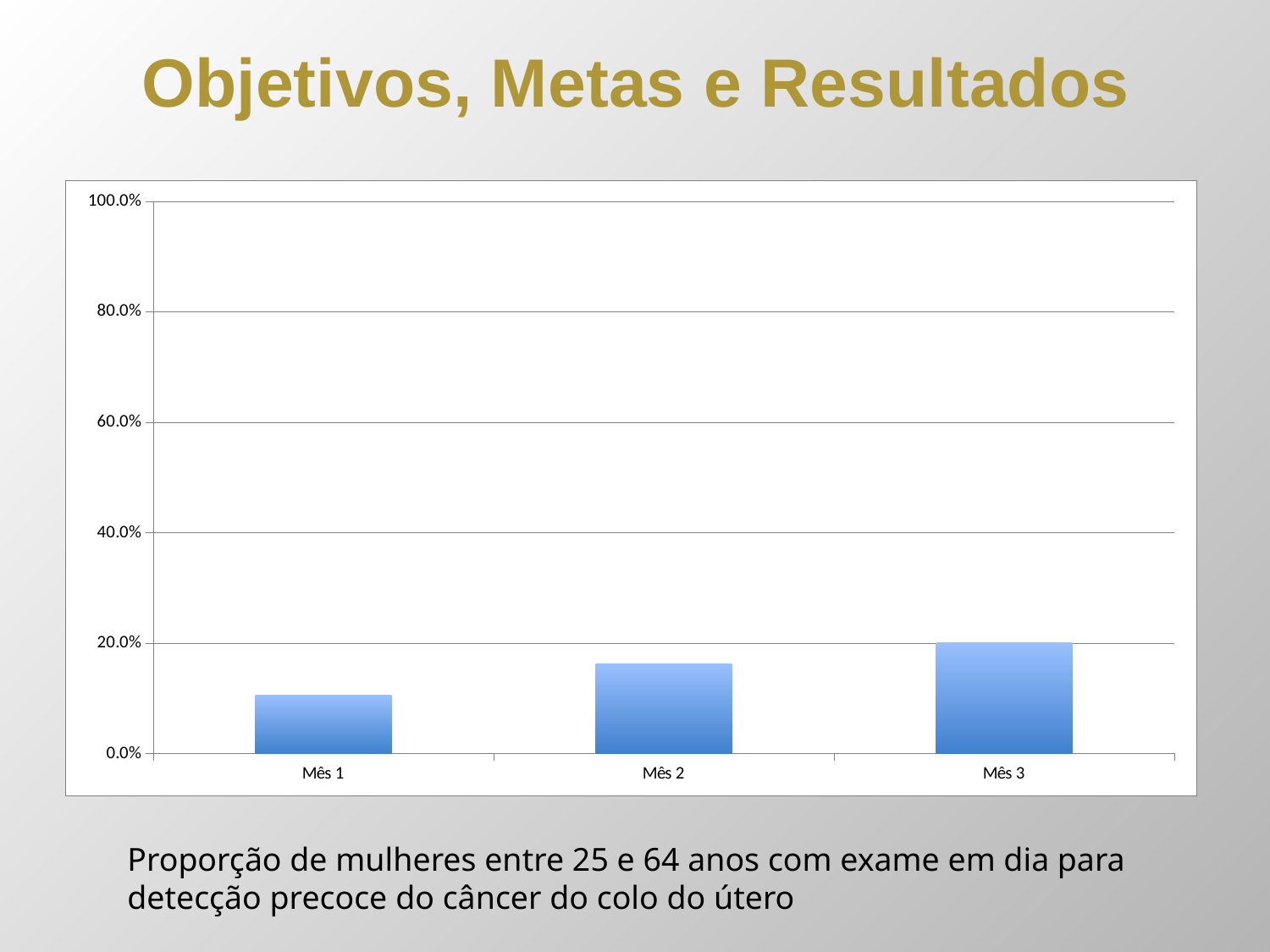
Is the value for Mês 2 greater or less than 20.0%? less Do the values rise or fall from Mês 1 to Mês 3? Rise What is the label of the first category on the x axis? Mês 1 Is the value for Mês 1 greater or less than 20.0%? less How many categories are plotted on the x axis of the chart? 3 Is the value for Mês 3 greater or less than 40.0%? less What kind of chart is shown on the slide? Bar chart Which is larger, the value for Mês 1 or the value for Mês 2? Mês 2 Which category has the highest bar in the chart? Mês 3 Which is larger, the value for Mês 2 or the value for Mês 3? Mês 3 Which category has the lowest bar in the chart? Mês 1 What is the highest value shown on the chart's vertical axis? 100.0%